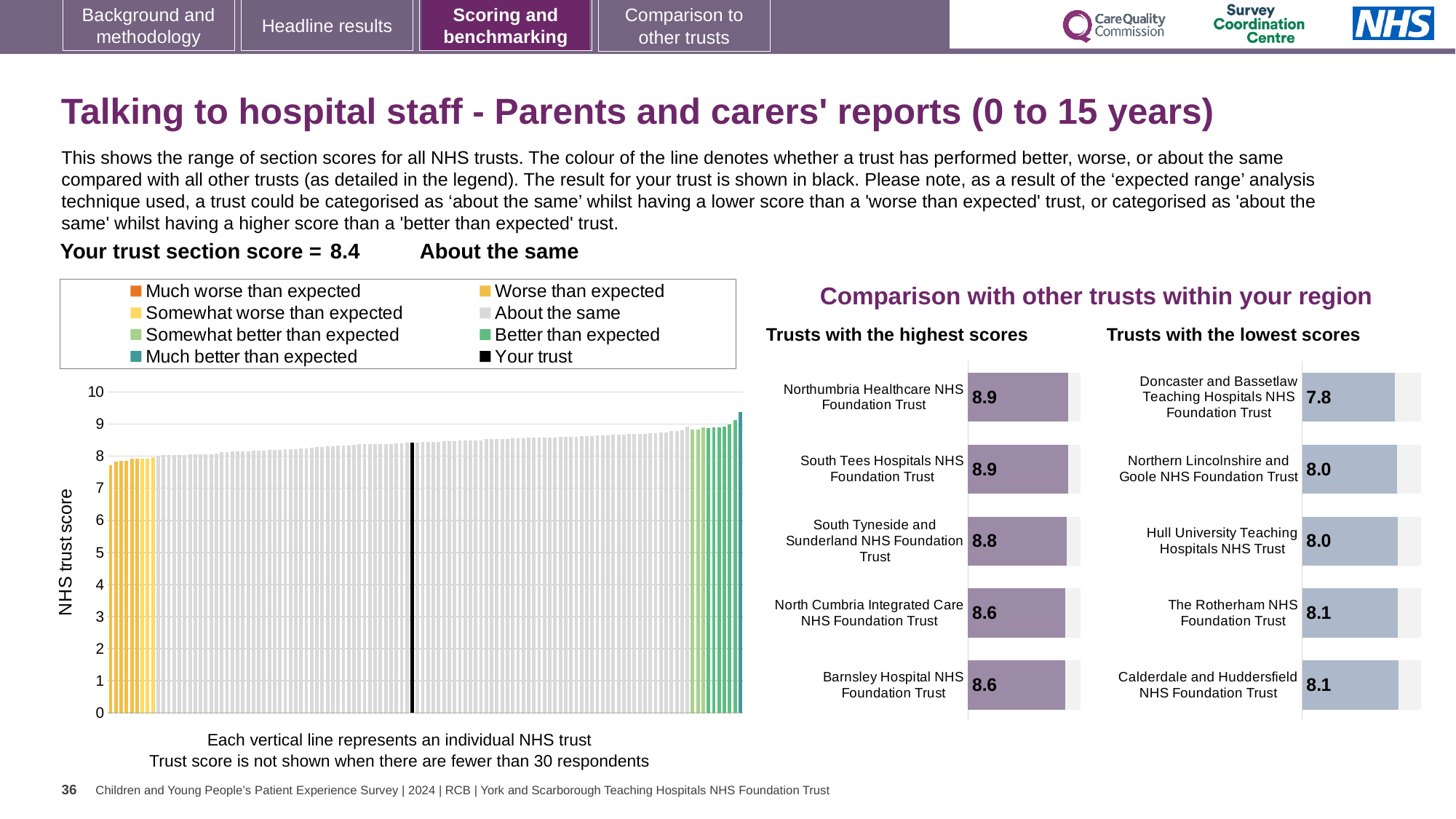
On the main chart on the left, is the value for your trust greater or less than 8? greater On the 'Trusts with the highest scores' chart, what is the difference between the scores of Northumbria Healthcare NHS Foundation Trust and Barnsley Hospital NHS Foundation Trust? 0.3 Which is larger: the score for South Tyneside and Sunderland NHS Foundation Trust on the highest scores chart, or the score for Hull University Teaching Hospitals NHS Trust on the lowest scores chart? South Tyneside and Sunderland NHS Foundation Trust On the main chart on the left, what is the section score for your trust? 8.4 On the 'Trusts with the highest scores' chart, what is the score for Northumbria Healthcare NHS Foundation Trust? 8.9 How many trusts are shown on the 'Trusts with the highest scores' chart? 5 On the 'Trusts with the lowest scores' chart, which trust has the lowest score? Doncaster and Bassetlaw Teaching Hospitals NHS Foundation Trust On the main chart on the left, do the trust scores rise or fall from left to right along the x axis? rise How many entries does the legend of the main chart on the left list? 8 On the 'Trusts with the lowest scores' chart, what is the difference between the scores of Calderdale and Huddersfield NHS Foundation Trust and Doncaster and Bassetlaw Teaching Hospitals NHS Foundation Trust? 0.3 On the 'Trusts with the lowest scores' chart, what is the score for Doncaster and Bassetlaw Teaching Hospitals NHS Foundation Trust? 7.8 On the 'Trusts with the highest scores' chart, what is the score for South Tyneside and Sunderland NHS Foundation Trust? 8.8